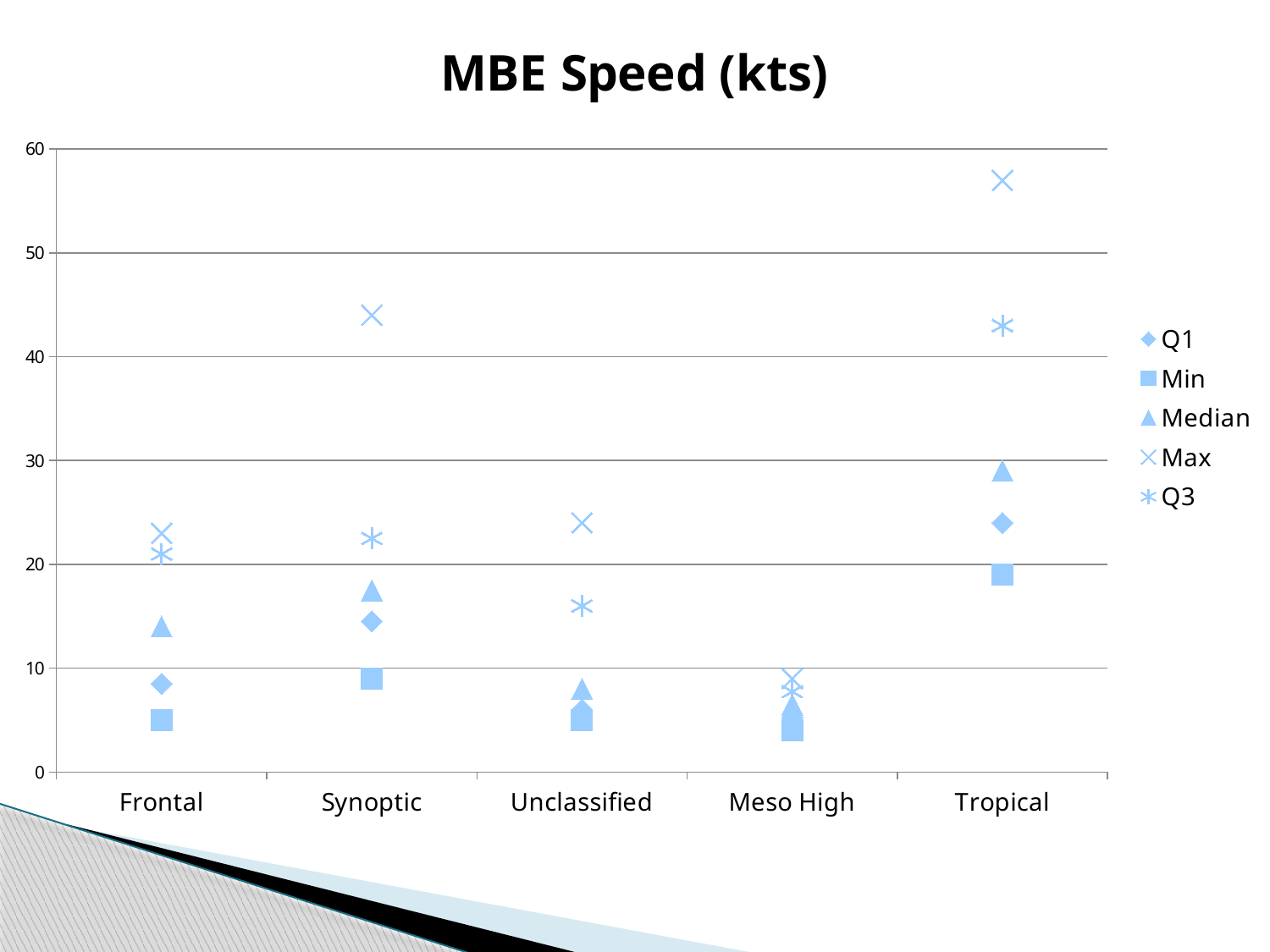
Which category has the highest Max value? Tropical What is the title of the chart? MBE Speed (kts) How many categories are shown on the x axis? 5 Is the Max value for Synoptic greater or less than 40? greater How many series does the legend list? 5 Which category has the highest Median value? Tropical Which is larger, the Max value for Synoptic or the Max value for Unclassified? Synoptic Is the Q3 value for Unclassified greater or less than 20? less Is the Max value for Tropical greater or less than 50? greater Which category has the lowest Max value? Meso High